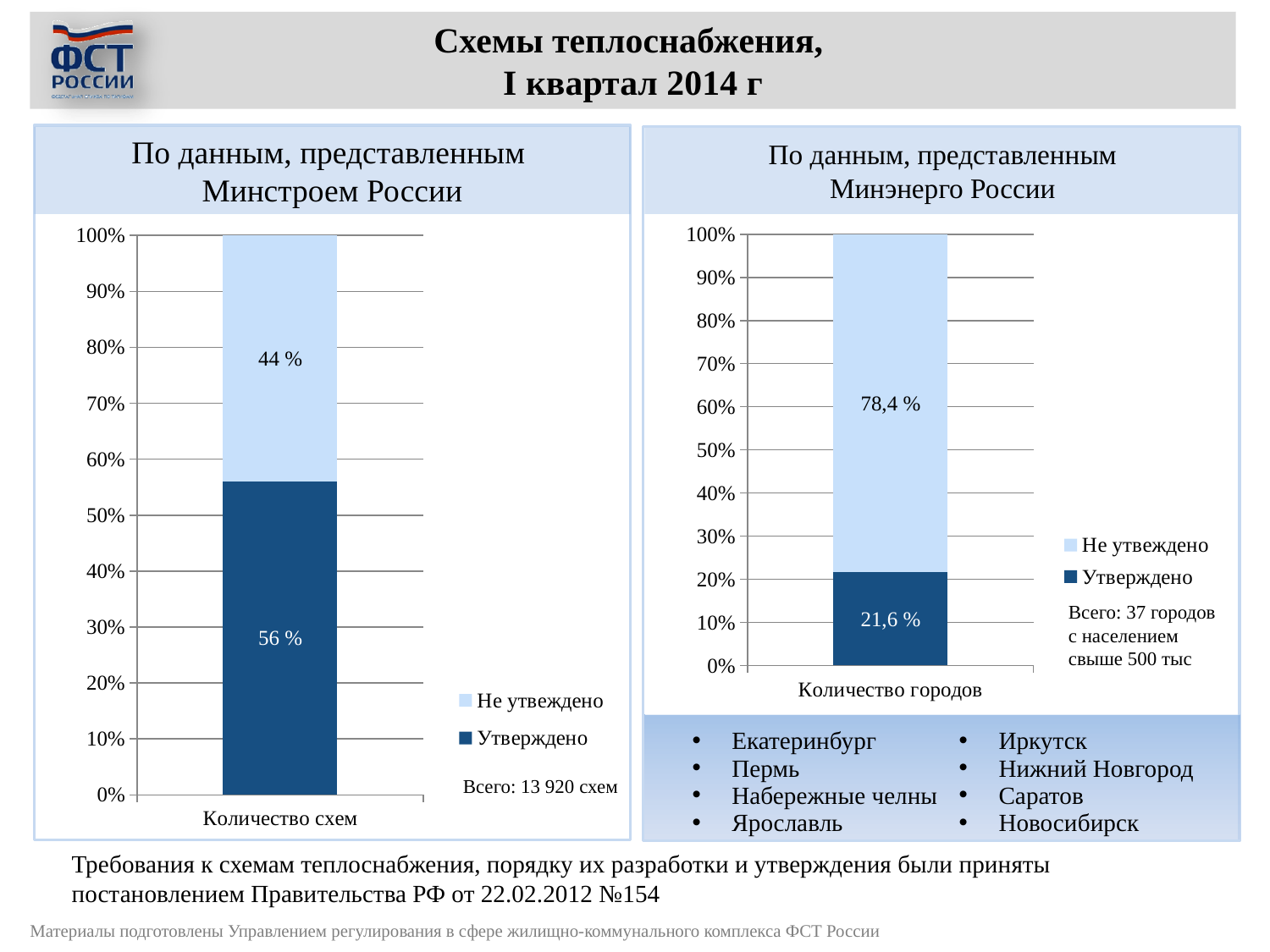
In the right chart (По данным, представленным Минэнерго России), what is the difference between the Не утвеждено and Утверждено values? 56,8 % In the left chart (По данным, представленным Минстроем России), what is the value for the Не утвеждено series? 44 % In the right chart (По данным, представленным Минэнерго России), what is the value for the Утверждено series? 21,6 % In the left chart (По данным, представленным Минстроем России), what is the value for the Утверждено series? 56 % In the right chart (По данным, представленным Минэнерго России), what is the total of the stacked bar for Количество городов? 100% What is the category label on the x axis of the left chart (По данным, представленным Минстроем России)? Количество схем How many series does the legend of the right chart (По данным, представленным Минэнерго России) list? 2 In the right chart (По данным, представленным Минэнерго России), what is the value for the Не утвеждено series? 78,4 % In the left chart (По данным, представленным Минстроем России), what is the difference between the Утверждено and Не утвеждено values? 12 % In the right chart (По данным, представленным Минэнерго России), which series has the larger value, Утверждено or Не утвеждено? Не утвеждено In the left chart (По данным, представленным Минстроем России), which series has the larger value, Утверждено or Не утвеждено? Утверждено What type of chart is the left chart (По данным, представленным Минстроем России)? Stacked bar chart